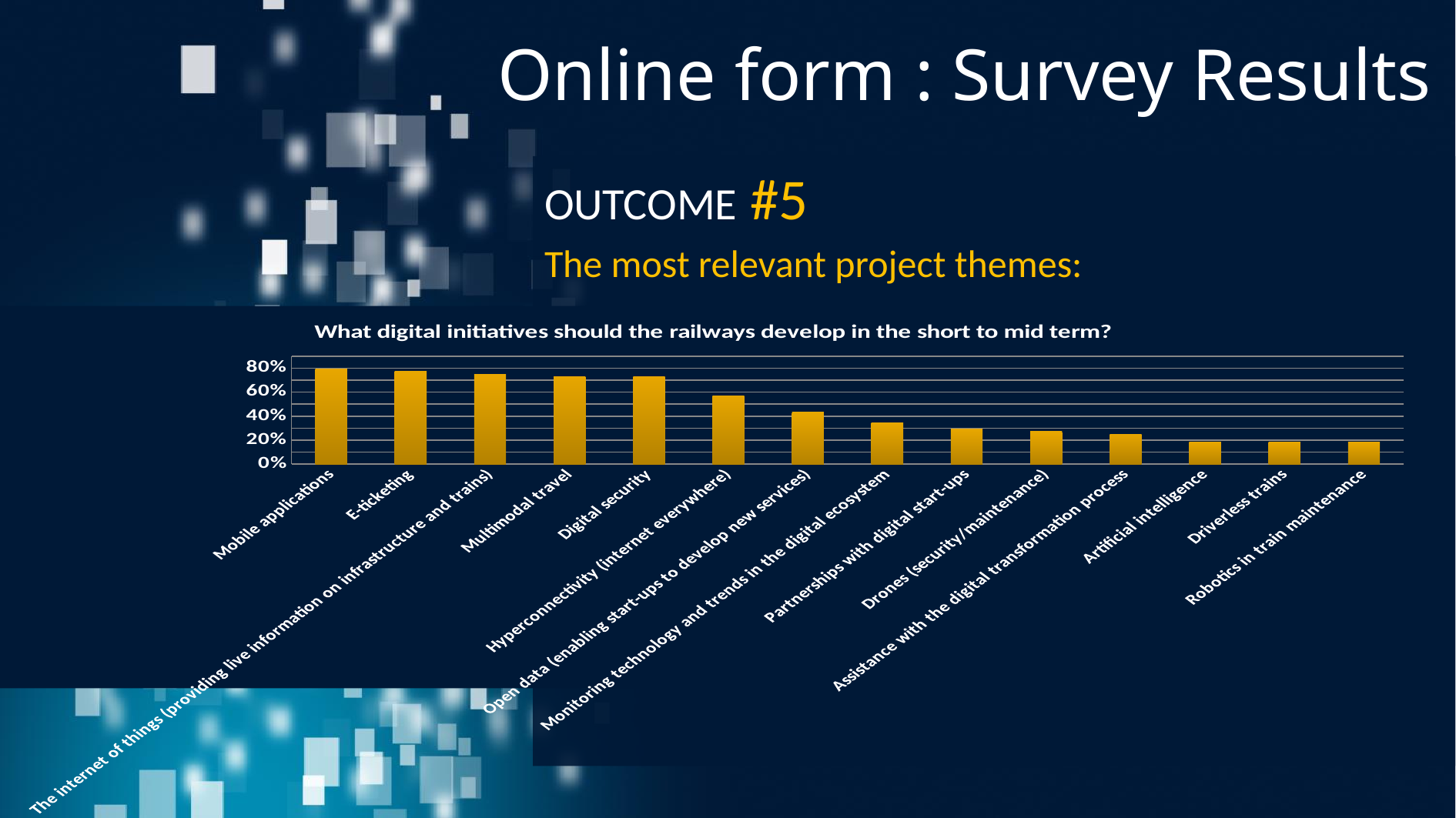
Is the value for Artificial intelligence greater or less than 40%? less Is the value for Mobile applications greater or less than 60%? greater How many categories (digital initiatives) are plotted in the chart? 14 Is the value for Open data (enabling start-ups to develop new services) greater or less than 60%? less What kind of chart is shown on the slide? Bar chart Which has the larger value, Hyperconnectivity (internet everywhere) or Open data (enabling start-ups to develop new services)? Hyperconnectivity (internet everywhere) Do the bar values rise or fall moving from left to right along the x axis? Fall What is the title of the chart? What digital initiatives should the railways develop in the short to mid term? Which has the larger value, Digital security or Driverless trains? Digital security Which has the larger value, Mobile applications or Drones (security/maintenance)? Mobile applications